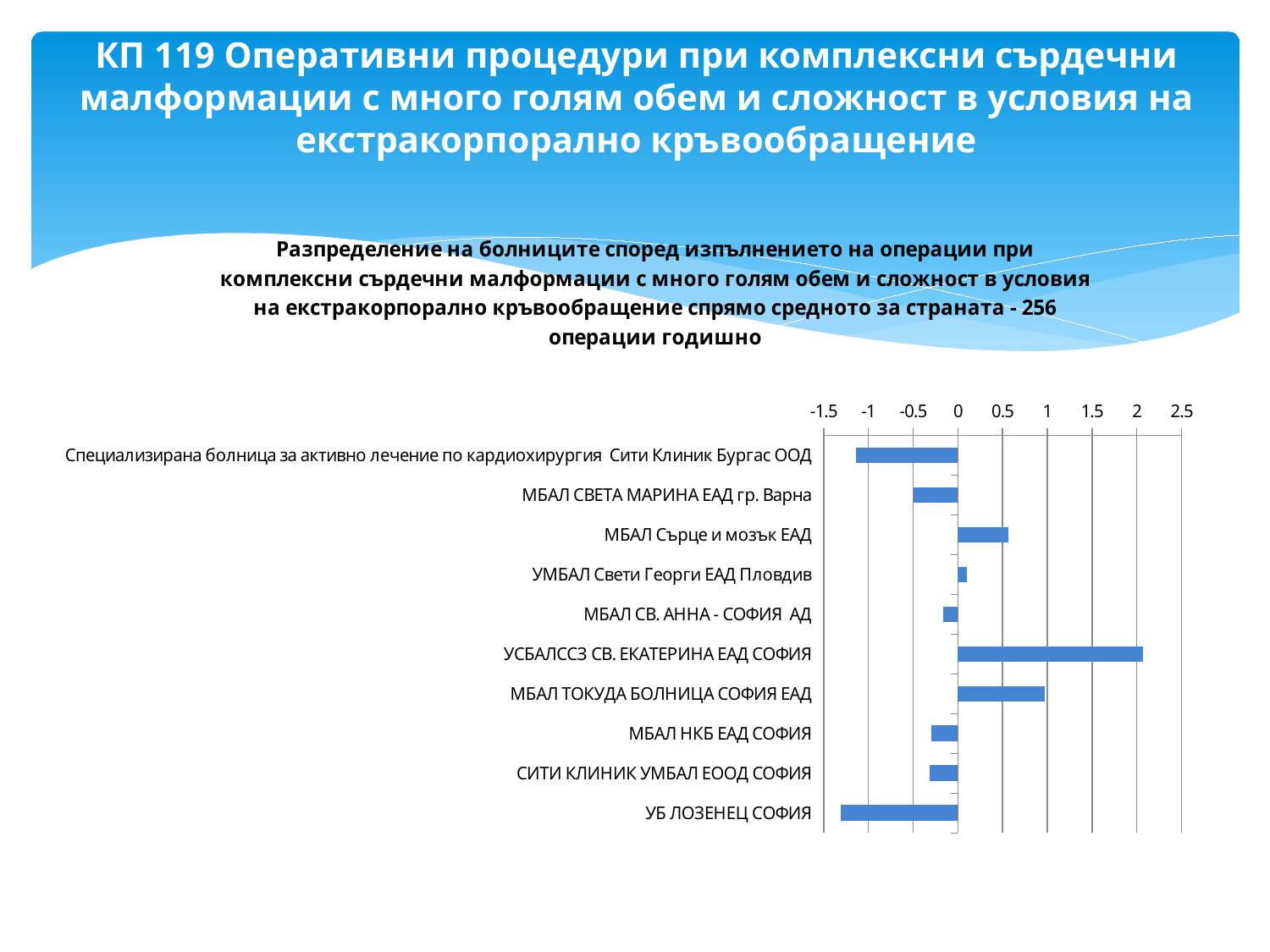
Which hospital has the lowest value in the chart? УБ ЛОЗЕНЕЦ СОФИЯ Is the value for УБ ЛОЗЕНЕЦ СОФИЯ greater or less than -1? less Is the value for МБАЛ ТОКУДА БОЛНИЦА СОФИЯ ЕАД greater or less than 0.5? greater Is the value for Специализирана болница за активно лечение по кардиохирургия Сити Клиник Бургас ООД greater or less than -1? less Which has the larger value: МБАЛ ТОКУДА БОЛНИЦА СОФИЯ ЕАД or МБАЛ СВЕТА МАРИНА ЕАД гр. Варна? МБАЛ ТОКУДА БОЛНИЦА СОФИЯ ЕАД Which has the larger value: МБАЛ Сърце и мозък ЕАД or УМБАЛ Свети Георги ЕАД Пловдив? МБАЛ Сърце и мозък ЕАД What is the maximum value shown on the horizontal axis of the chart? 2.5 What is the national average number of operations per year stated in the chart title? 256 Which hospital has the highest value in the chart? УСБАЛССЗ СВ. ЕКАТЕРИНА ЕАД СОФИЯ What kind of chart is shown on the slide? bar chart How many hospitals (categories) are plotted in the chart? 10